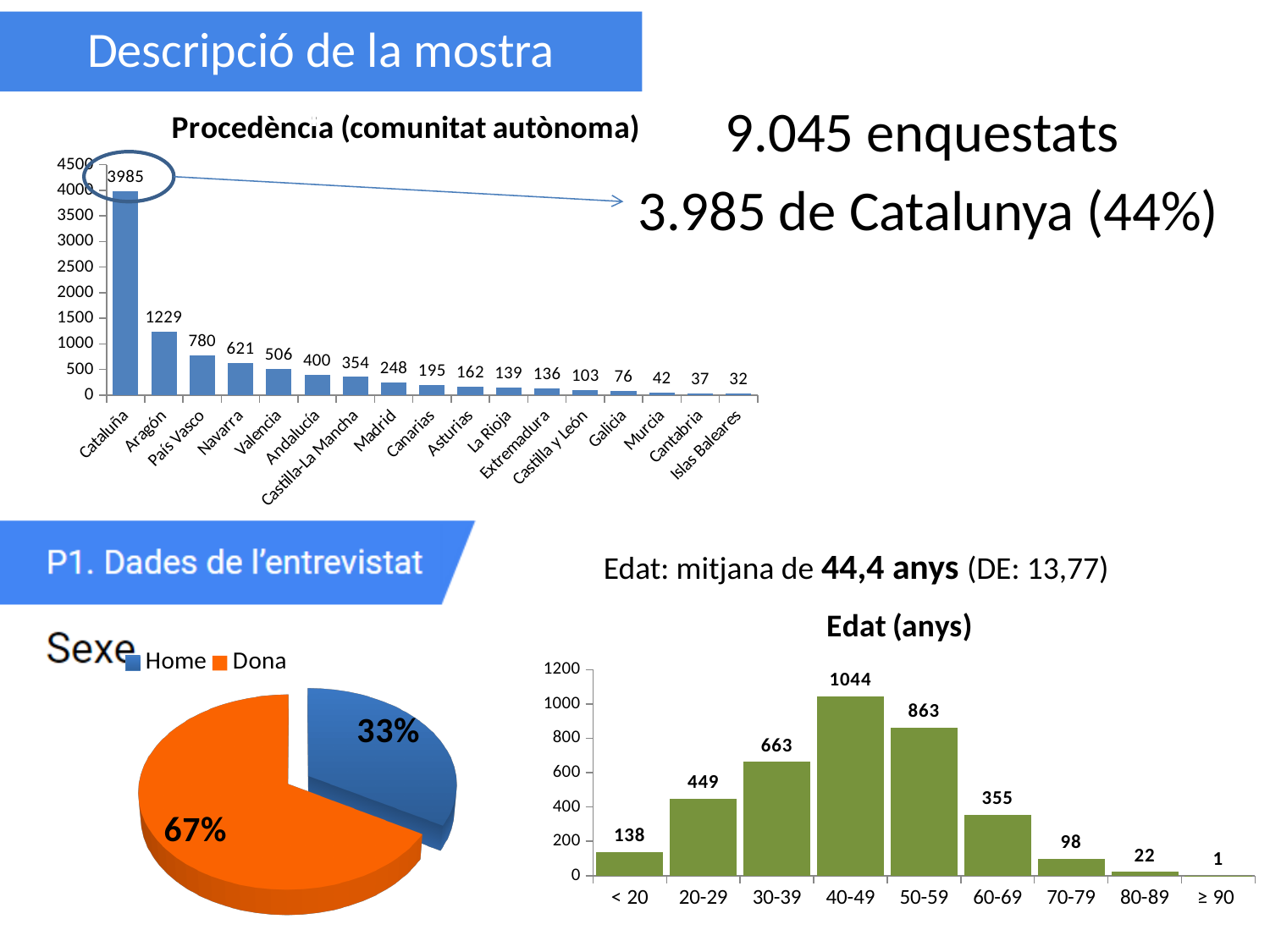
In the 'Sexe' pie chart, which is larger, Home or Dona? Dona In the 'Procedència (comunitat autònoma)' chart, which category has the highest value? Cataluña In the 'Sexe' pie chart, what share is shown for Dona? 67% In the 'Procedència (comunitat autònoma)' chart, what is the value for Aragón? 1229 In the 'Edat (anys)' chart, what is the value for the 40-49 category? 1044 In the 'Procedència (comunitat autònoma)' chart, what is the difference between the values for País Vasco and Navarra? 159 In the 'Edat (anys)' chart, what is the difference between the values for 50-59 and 60-69? 508 What kind of chart is the 'Sexe' chart? Pie chart In the 'Procedència (comunitat autònoma)' chart, how many categories are shown on the x axis? 17 In the 'Procedència (comunitat autònoma)' chart, which category has the lowest value? Islas Baleares What kind of chart is the 'Edat (anys)' chart? Bar chart In the 'Procedència (comunitat autònoma)' chart, what is the value for Madrid? 248